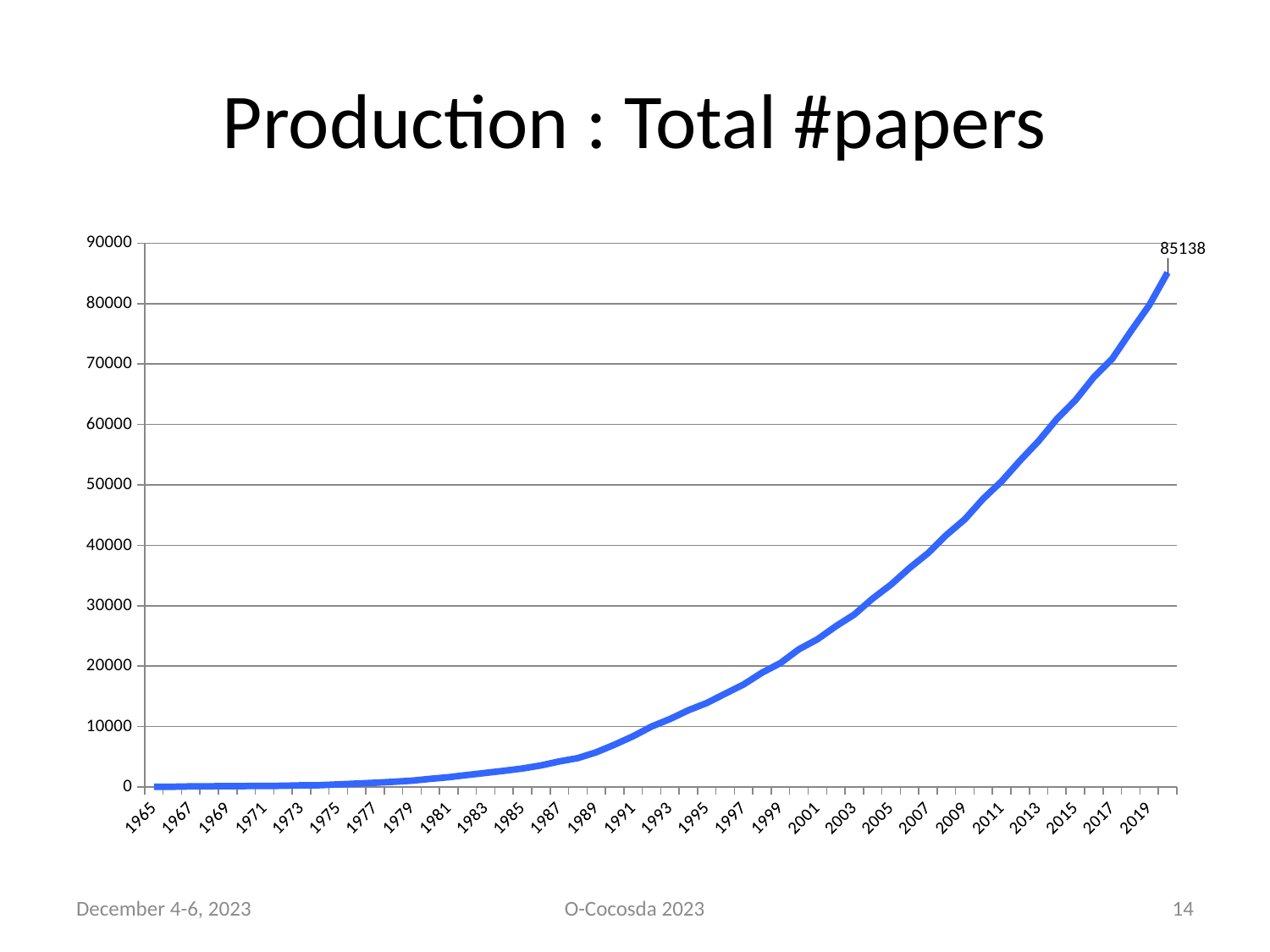
Is the value for 2007 greater or less than 30000? greater Is the value for 2013 greater or less than 50000? greater What is the first year label shown on the x axis? 1965 Is the value for 1985 greater or less than 10000? less Do the values rise or fall as the years increase along the x axis? rise Which is larger, the value for 2001 or the value for 1995? 2001 What value is printed as the data label at the end of the line? 85138 What kind of chart is shown on the slide? line chart What is the title of the chart? Production : Total #papers